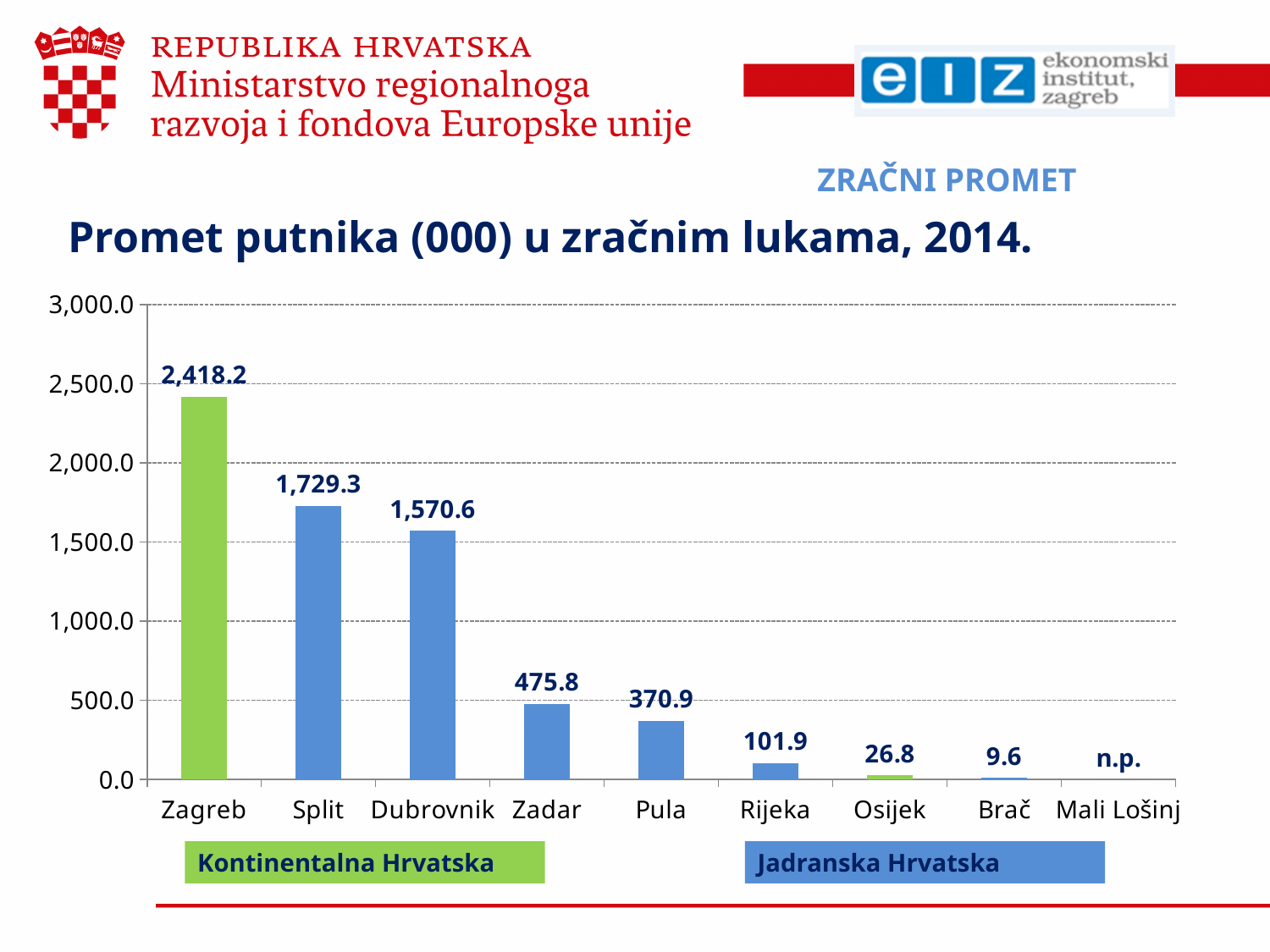
What is the value for Zagreb? 2,418.2 Which airport with a numeric value has the lowest passenger traffic? Brač What is the difference between the values for Split and Dubrovnik? 158.7 Which is larger, the value for Zadar or the value for Pula? Zadar What is shown for Mali Lošinj? n.p. What is the value for Dubrovnik? 1,570.6 Which group do the green bars represent according to the legend? Kontinentalna Hrvatska How many airports are listed on the x axis? 9 Which airport has the highest passenger traffic? Zagreb What is the value for Rijeka? 101.9 Do the values rise or fall from left to right along the x axis? fall What kind of chart is this? bar chart